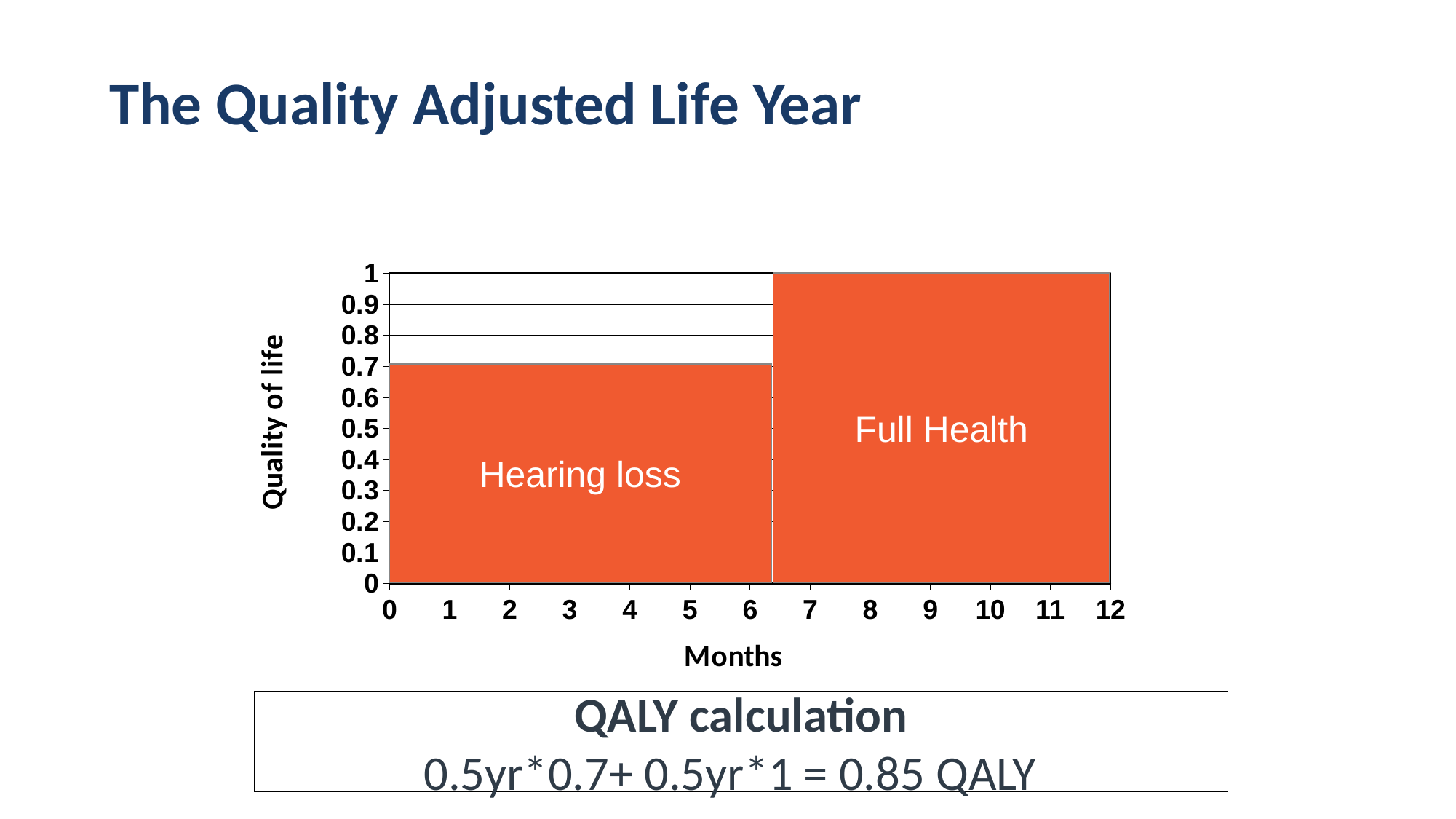
What is the quality of life value for the Full Health bar? 1 What is the label of the y axis? Quality of life What is the difference in quality of life between Full Health and Hearing loss? 0.3 Which bar has the lowest quality of life value? Hearing loss What is the label of the x axis? Months Is the quality of life value for Hearing loss greater or less than 0.5? greater What is the quality of life value for the Hearing loss bar? 0.7 Do the values rise or fall along the x axis from left to right? rise How many bars are plotted in the chart? 2 Which bar is higher, Hearing loss or Full Health? Full Health Which bar has the highest quality of life value? Full Health What kind of chart is shown on the slide? bar chart